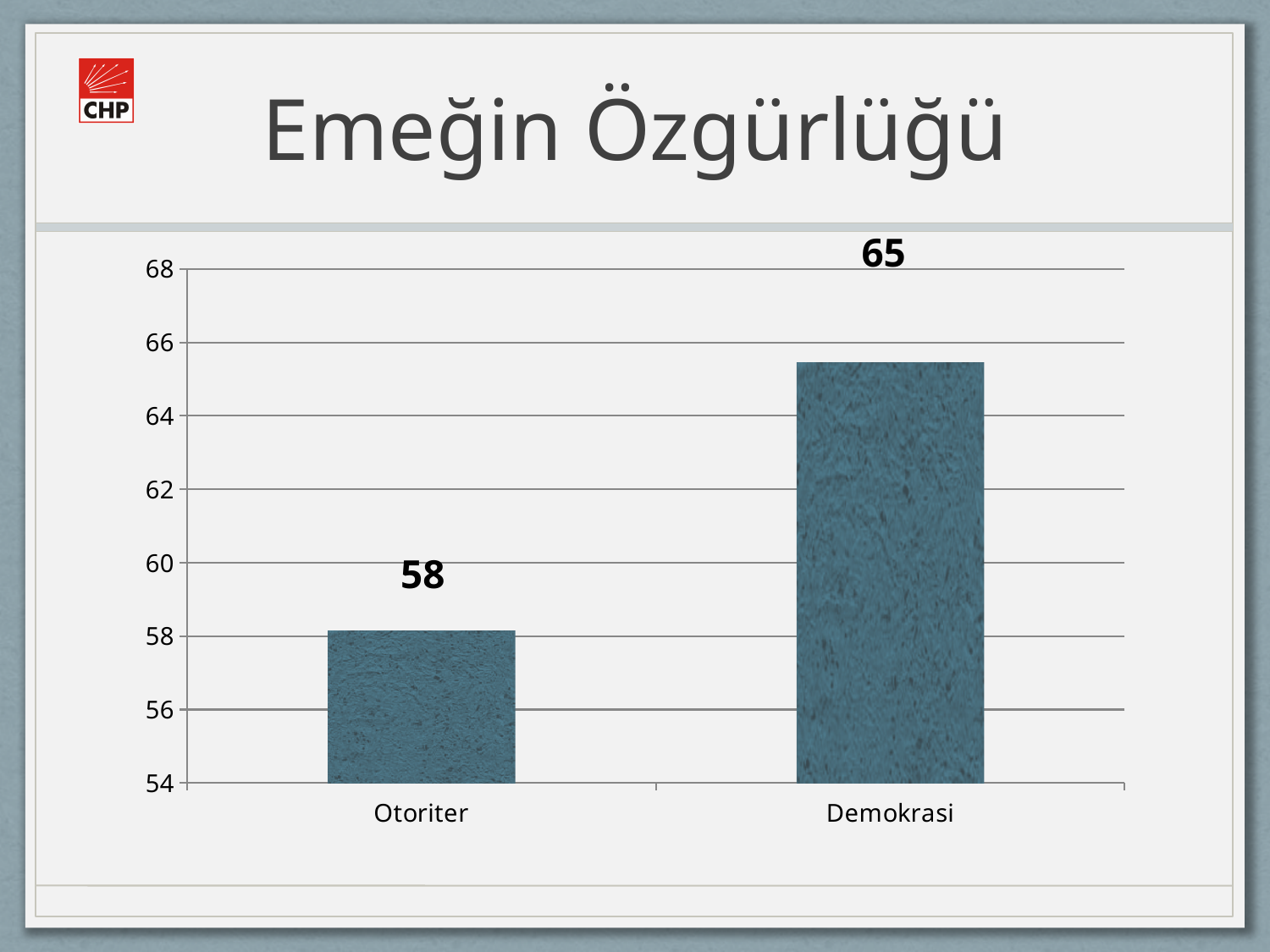
What is the value for Otoriter? 58 How many categories are shown on the x axis? 2 Which category has the highest value? Demokrasi What kind of chart is shown on the slide? bar chart Which is larger, the value for Otoriter or the value for Demokrasi? Demokrasi What is the lowest value shown on the y axis? 54 Which category has the lowest value? Otoriter What is the title of the slide containing the chart? Emeğin Özgürlüğü Is the value for Otoriter greater or less than 60? less What is the difference between the values for Demokrasi and Otoriter? 7 Is the value for Demokrasi greater or less than 62? greater What is the value for Demokrasi? 65